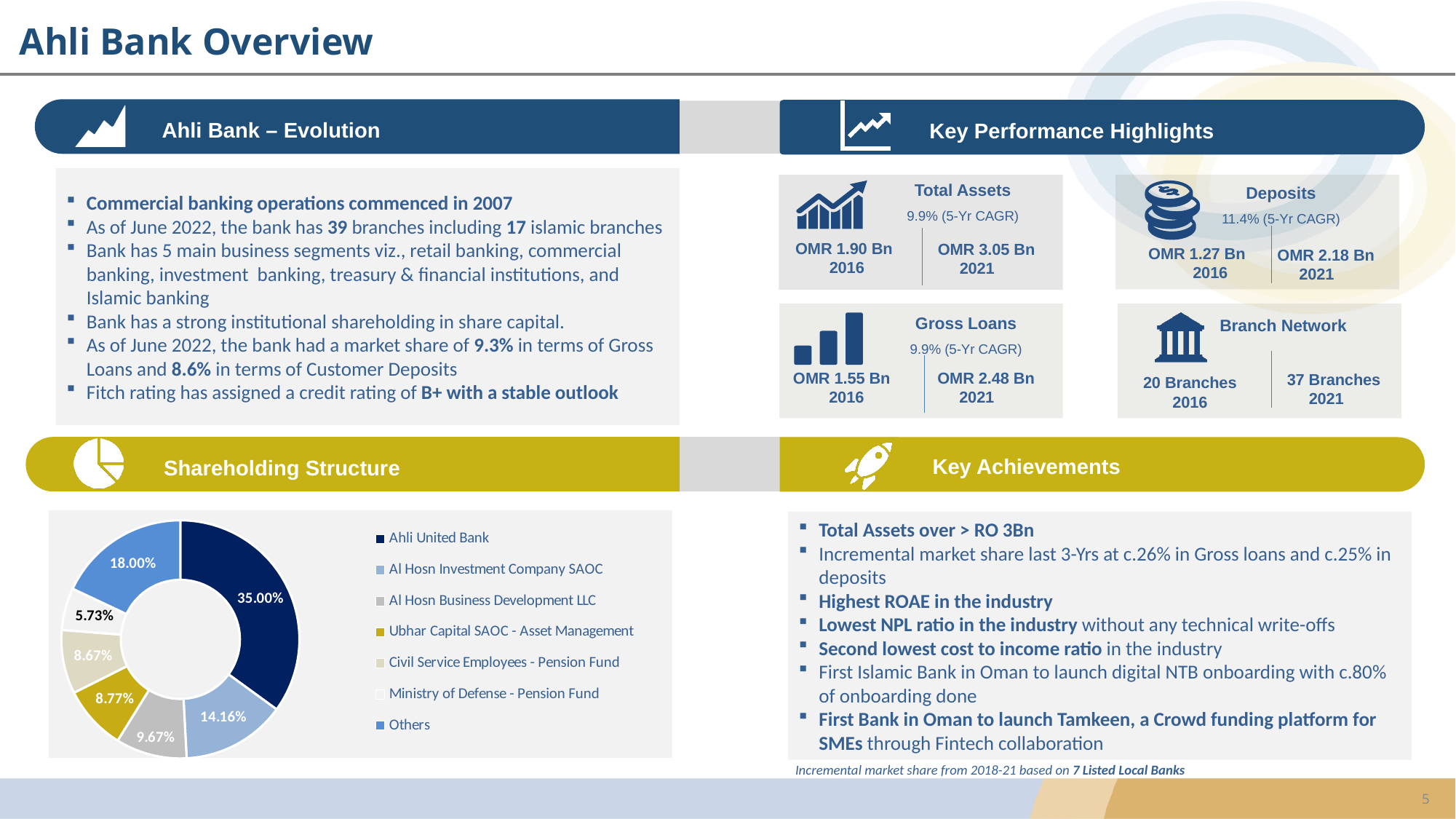
Which shareholder has the smallest slice in the Shareholding Structure chart? Ministry of Defense - Pension Fund In the Shareholding Structure chart, what is the difference between the shares of Ahli United Bank and Others? 17.00% In the Shareholding Structure chart, what share does Ubhar Capital SAOC - Asset Management hold? 8.77% What type of chart is shown in the Shareholding Structure section? Doughnut chart In the Shareholding Structure chart, what share does Ministry of Defense - Pension Fund hold? 5.73% In the Shareholding Structure chart, what share does Al Hosn Investment Company SAOC hold? 14.16% In the Shareholding Structure chart, what share is held by Others? 18.00% In the Shareholding Structure chart, what share does Ahli United Bank hold? 35.00% How many shareholder categories are shown in the Shareholding Structure chart? 7 In the Shareholding Structure chart, which is larger: the share of Al Hosn Business Development LLC or Civil Service Employees - Pension Fund? Al Hosn Business Development LLC Which shareholder has the largest slice in the Shareholding Structure chart? Ahli United Bank In the Shareholding Structure chart, which shareholder is represented by the dark navy slice? Ahli United Bank